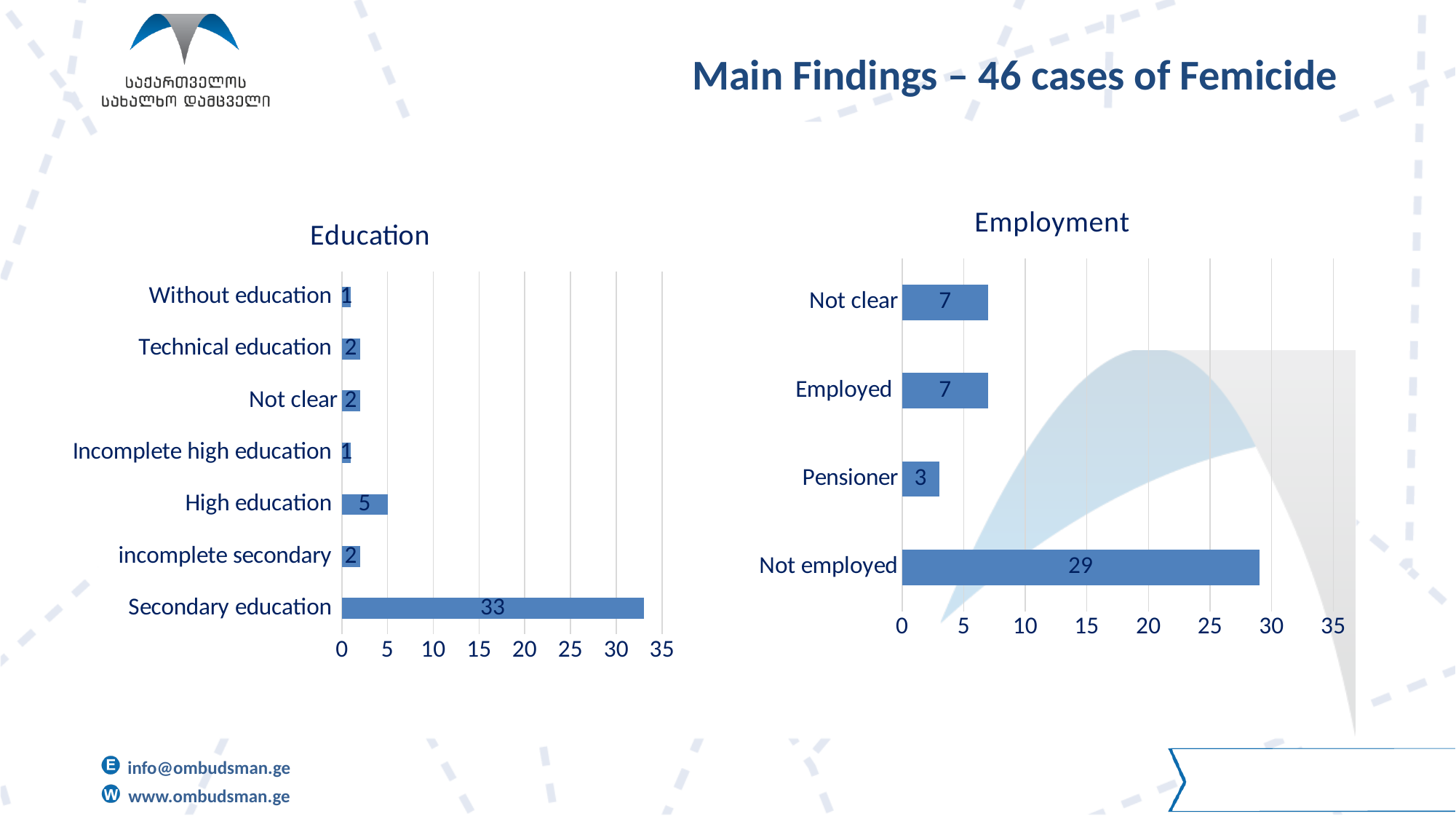
In the Education chart, what is the difference between Secondary education and High education? 28 In the Education chart, how many categories are shown? 7 What type of chart is the Education chart? Bar chart In the Education chart, what is the value for Secondary education? 33 In the Education chart, which category has the highest value? Secondary education In the Employment chart, what is the difference between Not employed and Employed? 22 In the Education chart, what is the value for High education? 5 In the Employment chart, what is the value for Not employed? 29 In the Employment chart, which category has the lowest value? Pensioner In the Employment chart, what is the value for Pensioner? 3 In the Employment chart, which is larger, Employed or Pensioner? Employed In the Employment chart, how many categories are shown? 4